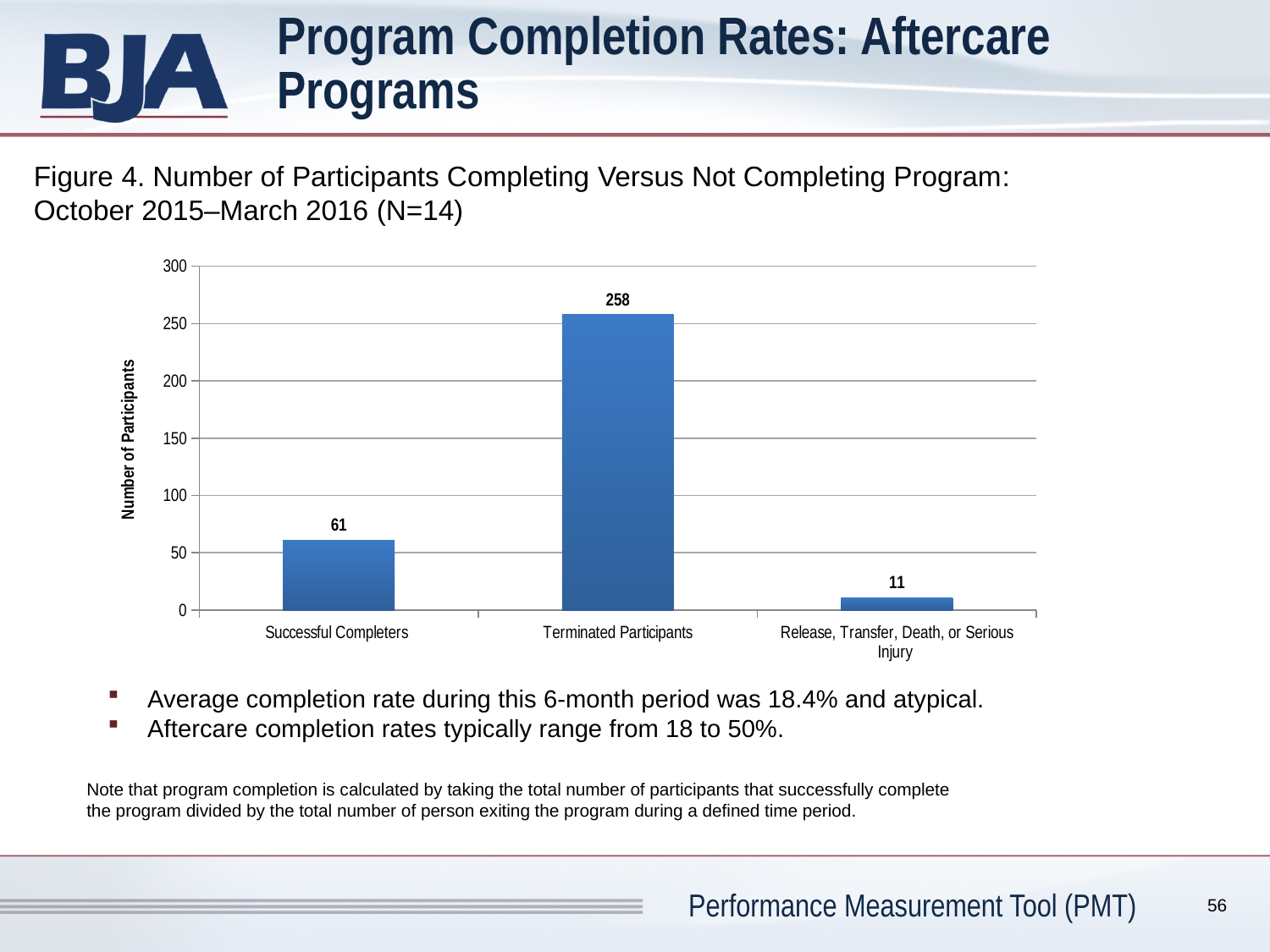
Which category has the lowest number of participants? Release, Transfer, Death, or Serious Injury Which category has the highest number of participants? Terminated Participants What is the label of the vertical axis of the chart? Number of Participants How many Terminated Participants are shown in the chart? 258 Is the value for Terminated Participants greater or less than 250? greater What is the value for Release, Transfer, Death, or Serious Injury? 11 What is the difference between Terminated Participants and Successful Completers? 197 How many categories are shown on the x axis of the chart? 3 Which is larger: Successful Completers or Terminated Participants? Terminated Participants How many participants were Successful Completers? 61 What is the difference between Successful Completers and Release, Transfer, Death, or Serious Injury? 50 What kind of chart is shown on the slide? bar chart